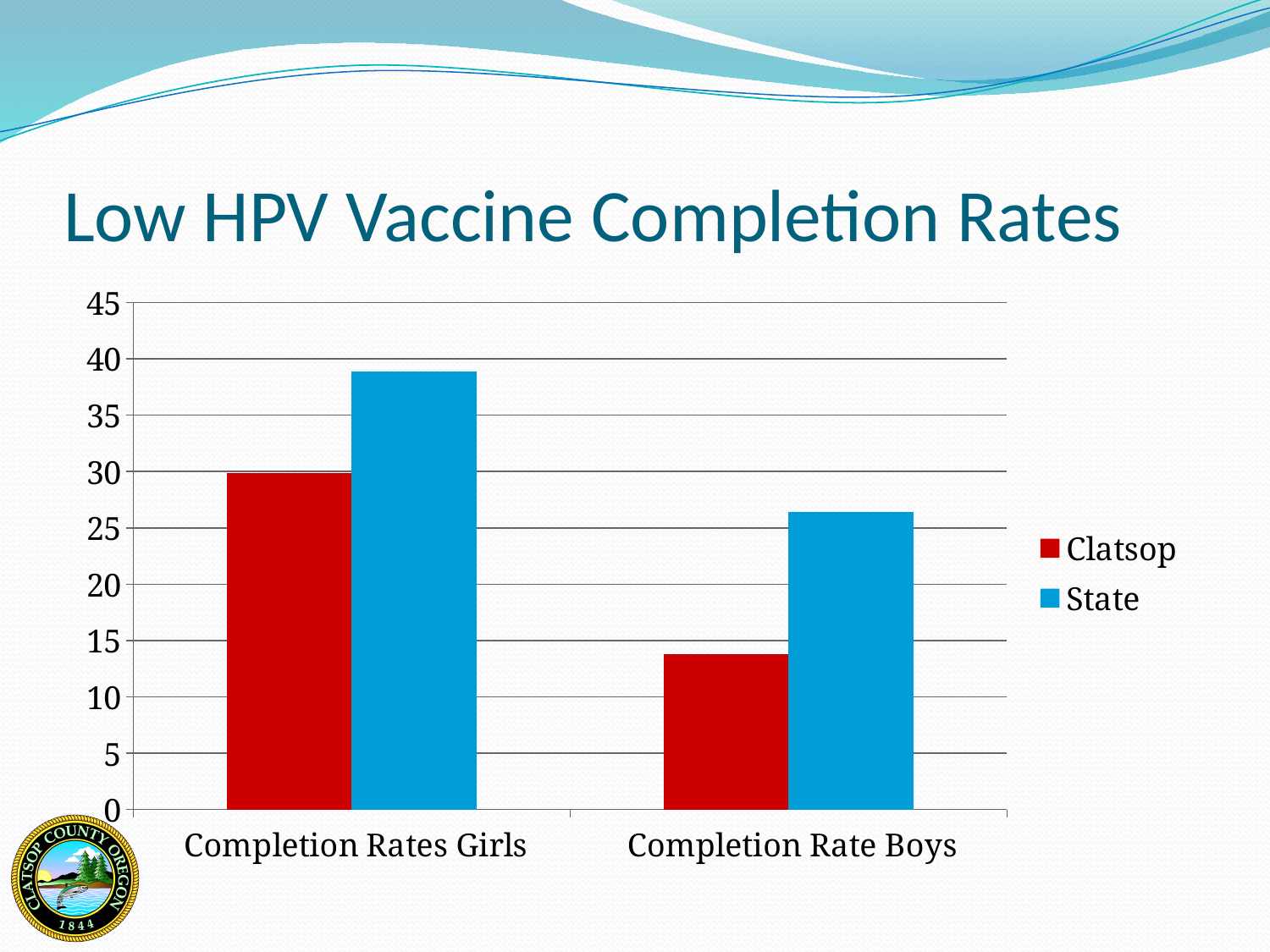
How many categories are shown on the x axis? 2 Is the State value for Completion Rates Girls greater or less than 35? greater What is the title of the slide containing the chart? Low HPV Vaccine Completion Rates Which bar is the lowest in the chart? Clatsop, Completion Rate Boys For Completion Rates Girls, which is larger: Clatsop or State? State Is the Clatsop value for Completion Rate Boys greater or less than 15? less What kind of chart is shown on the slide? bar chart For Completion Rate Boys, which is larger: Clatsop or State? State How many series does the legend list? 2 Is the Clatsop value for Completion Rates Girls greater or less than 25? greater Which series has the highest bar in the chart? State